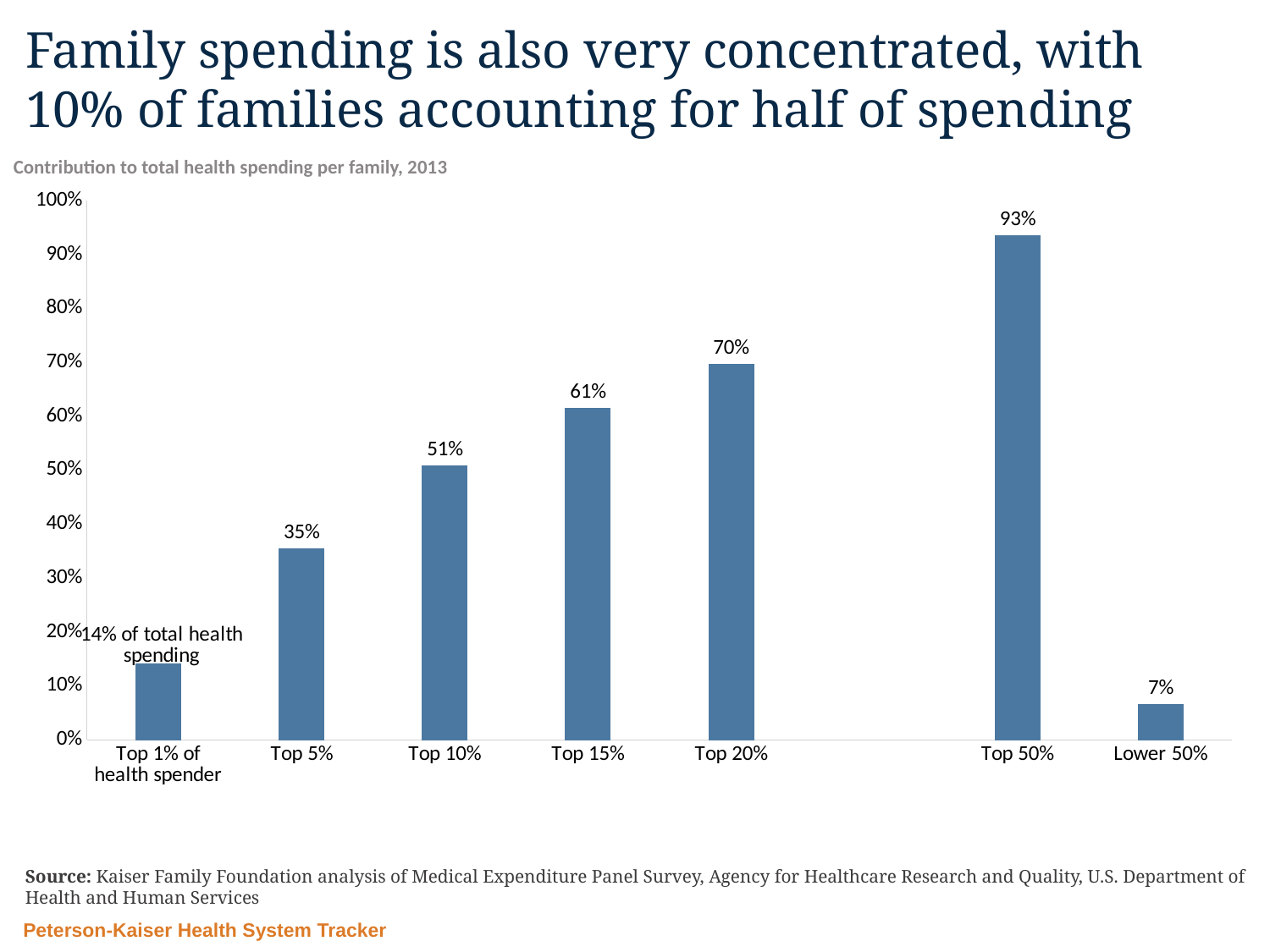
How many categories are shown on the chart? 7 Which category has the lowest value? Lower 50% What is the difference between the values for Top 20% and Top 5%? 35% Which category has the highest value? Top 50% What is the value for Top 10%? 51% What is the value for Top 50%? 93% Do the values rise or fall from Top 1% of health spender to Top 50%? Rise Which is larger, the value for Top 15% or the value for Top 5%? Top 15% What is the value for Top 1% of health spender? 14% What is the value for Lower 50%? 7% What is the chart's subtitle? Contribution to total health spending per family, 2013 What kind of chart is shown on the slide? Bar chart